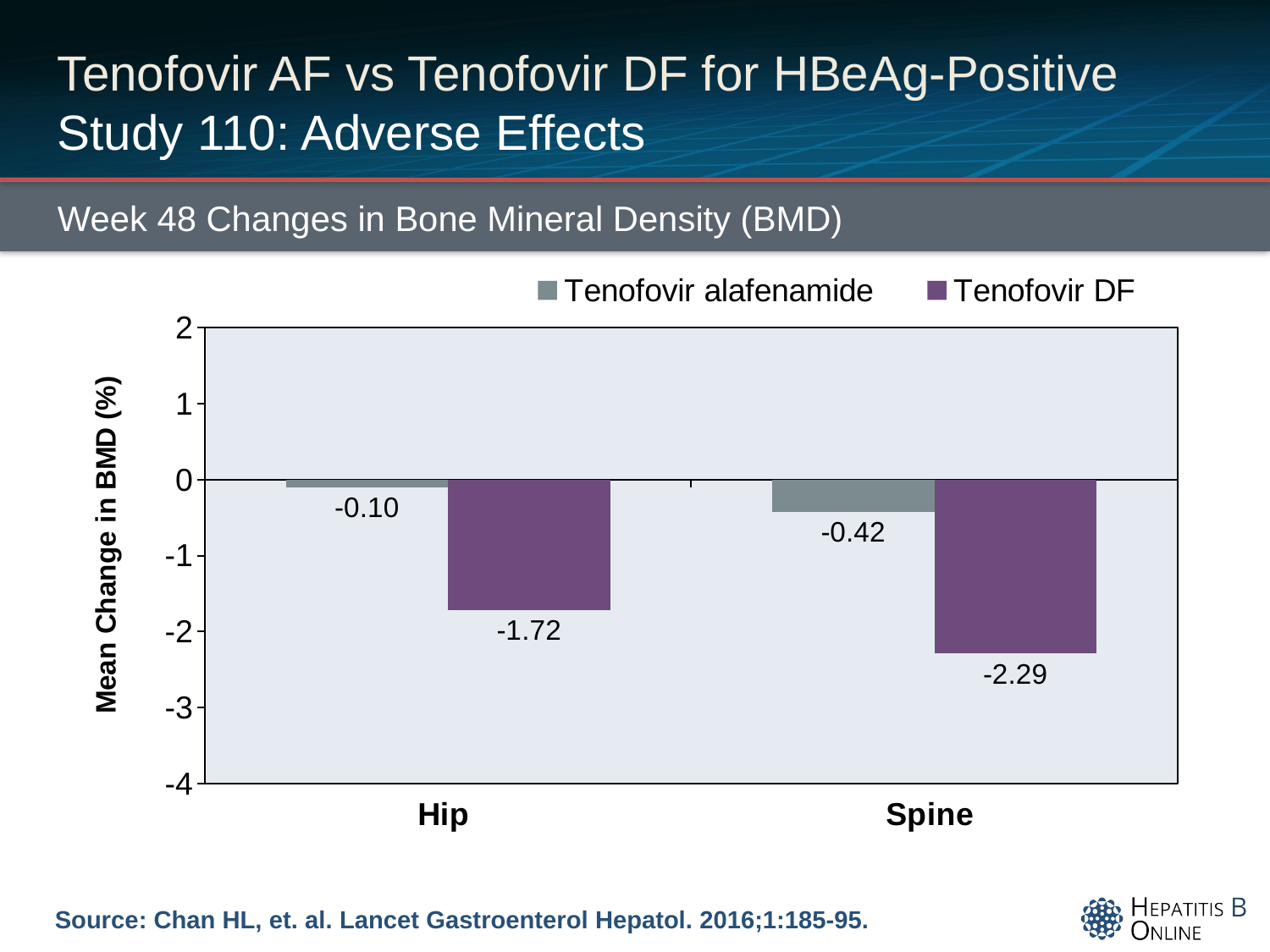
What kind of chart is shown on the slide? Bar chart What is the mean change in BMD for Tenofovir alafenamide at the Spine? -0.42 What is the difference between the Tenofovir DF and Tenofovir alafenamide values at the Hip? 1.62 What is the mean change in BMD for Tenofovir DF at the Hip? -1.72 What is the label of the y axis? Mean Change in BMD (%) Which series has the larger decrease in BMD at the Spine? Tenofovir DF What is the mean change in BMD for Tenofovir alafenamide at the Hip? -0.10 Which category shows the lowest (most negative) value for Tenofovir DF? Spine How many categories are shown on the x axis? 2 How many series does the legend list? 2 What is the difference between the Tenofovir DF and Tenofovir alafenamide values at the Spine? 1.87 What is the mean change in BMD for Tenofovir DF at the Spine? -2.29